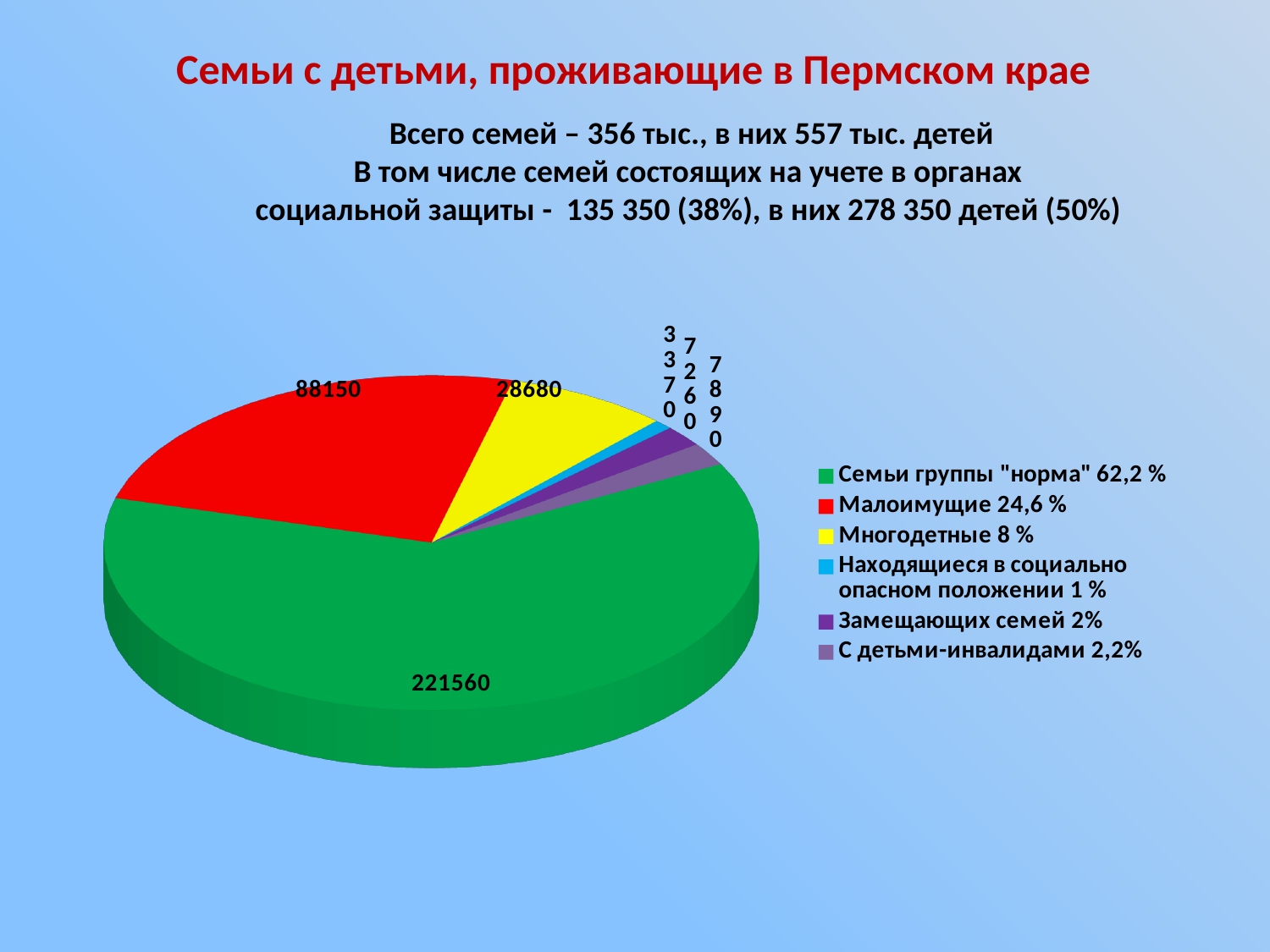
Which category has the largest slice of the pie? Семьи группы "норма" What share of the pie does Малоимущие represent, according to the legend? 24,6 % Which is larger, the value for Малоимущие or the value for Многодетные? Малоимущие What kind of chart is shown on the slide? Pie chart How many slices does the pie chart have? 6 What is the value shown for Малоимущие? 88150 What colour is the slice for Многодетные? Yellow What is the difference between the values for Семьи группы "норма" and Малоимущие? 133410 What is the difference between the values for Малоимущие and Многодетные? 59470 Which category has the smallest slice of the pie? Находящиеся в социально опасном положении What is the value shown for Семьи группы "норма"? 221560 What is the value shown for Многодетные? 28680